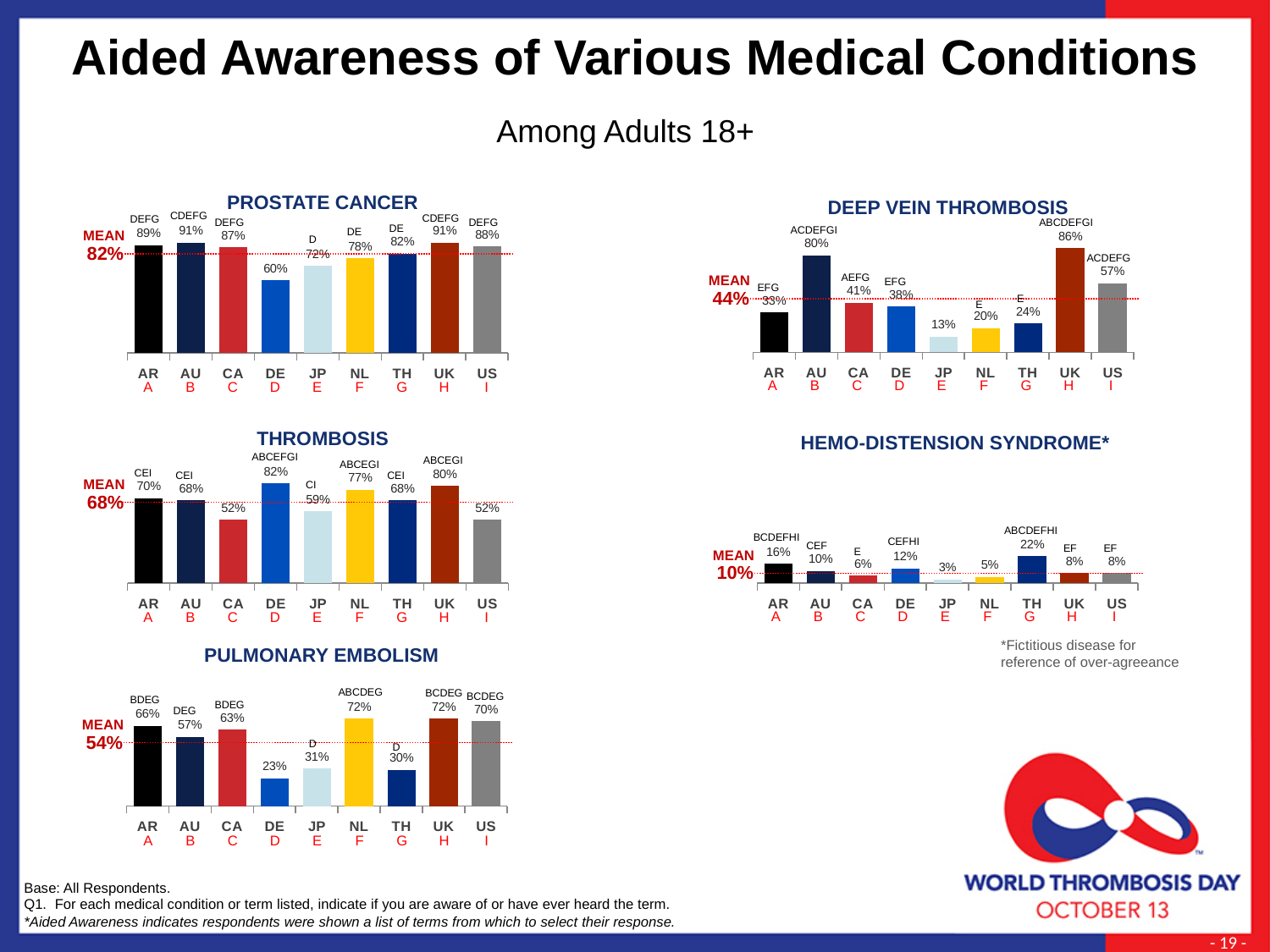
In the Pulmonary Embolism chart, which country has the lowest value? DE What is the mean value shown for the Pulmonary Embolism chart? 54% In the Hemo-Distension Syndrome chart, what is the value for TH? 22% In the Prostate Cancer chart, what is the value for DE? 60% In the Pulmonary Embolism chart, which is larger, the value for AR or the value for AU? AR In the Deep Vein Thrombosis chart, what is the difference between the values for UK and AU? 6% In the Deep Vein Thrombosis chart, which country has the highest value? UK What kind of chart is the Prostate Cancer chart? Bar chart In the Thrombosis chart, what is the difference between the values for NL and JP? 18% In the Deep Vein Thrombosis chart, which country has the lowest value? JP In the Thrombosis chart, which country has the highest value? DE How many countries are shown in the Hemo-Distension Syndrome chart? 9